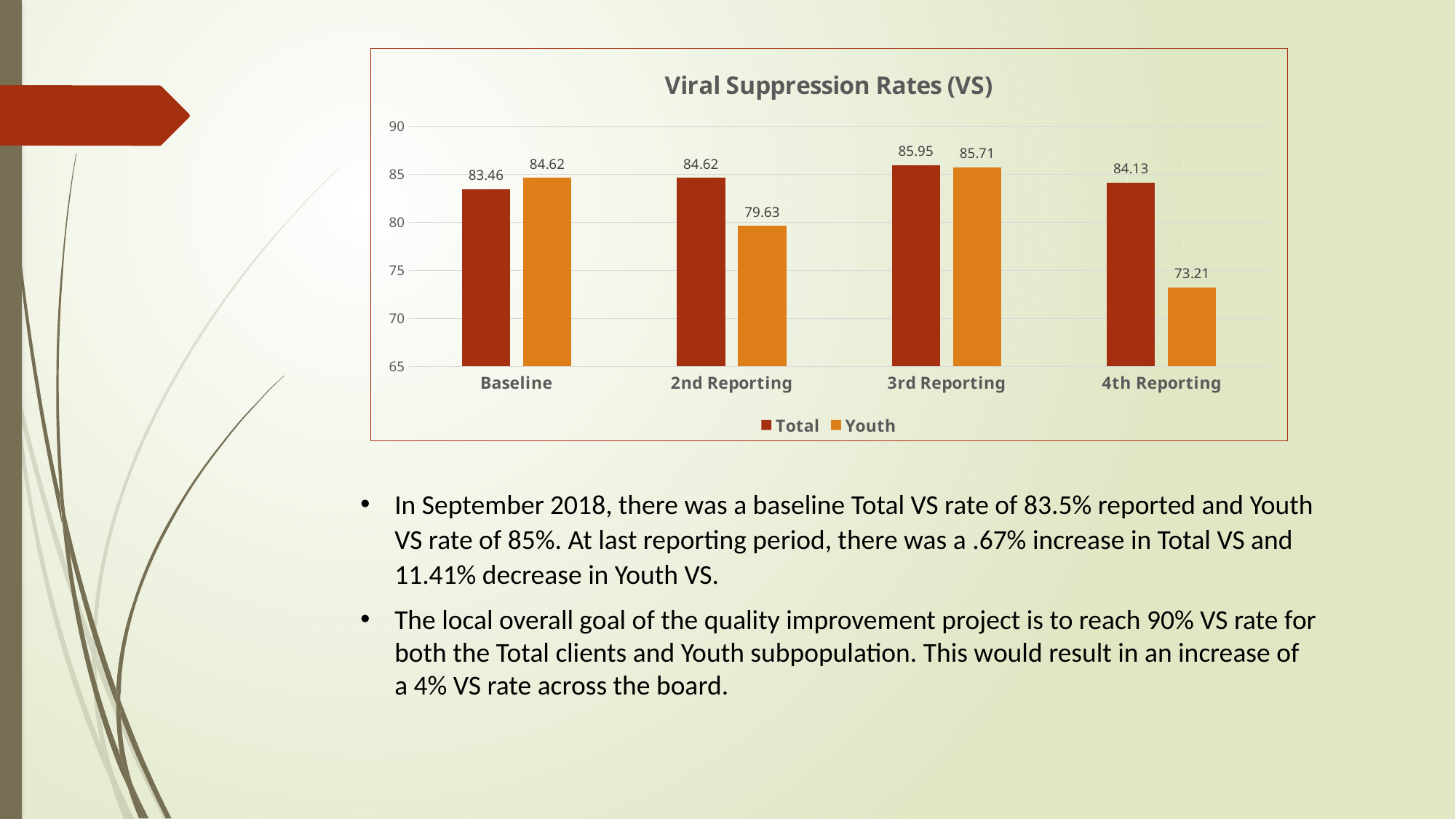
What is the title of the chart? Viral Suppression Rates (VS) How many reporting periods are shown on the x axis? 4 How many series does the legend list? 2 What is the Youth viral suppression rate at the 4th Reporting period? 73.21 What is the Total viral suppression rate at Baseline? 83.46 Which reporting period has the lowest Youth viral suppression rate? 4th Reporting Is the Youth value at the 3rd Reporting period greater or less than 85? greater What kind of chart is shown on the slide? Bar chart Which reporting period has the highest Total viral suppression rate? 3rd Reporting At the 2nd Reporting period, which is larger, the Total or the Youth value? Total What is the difference between the Total and Youth values at the 4th Reporting period? 10.92 What is the Youth value at the 2nd Reporting period? 79.63